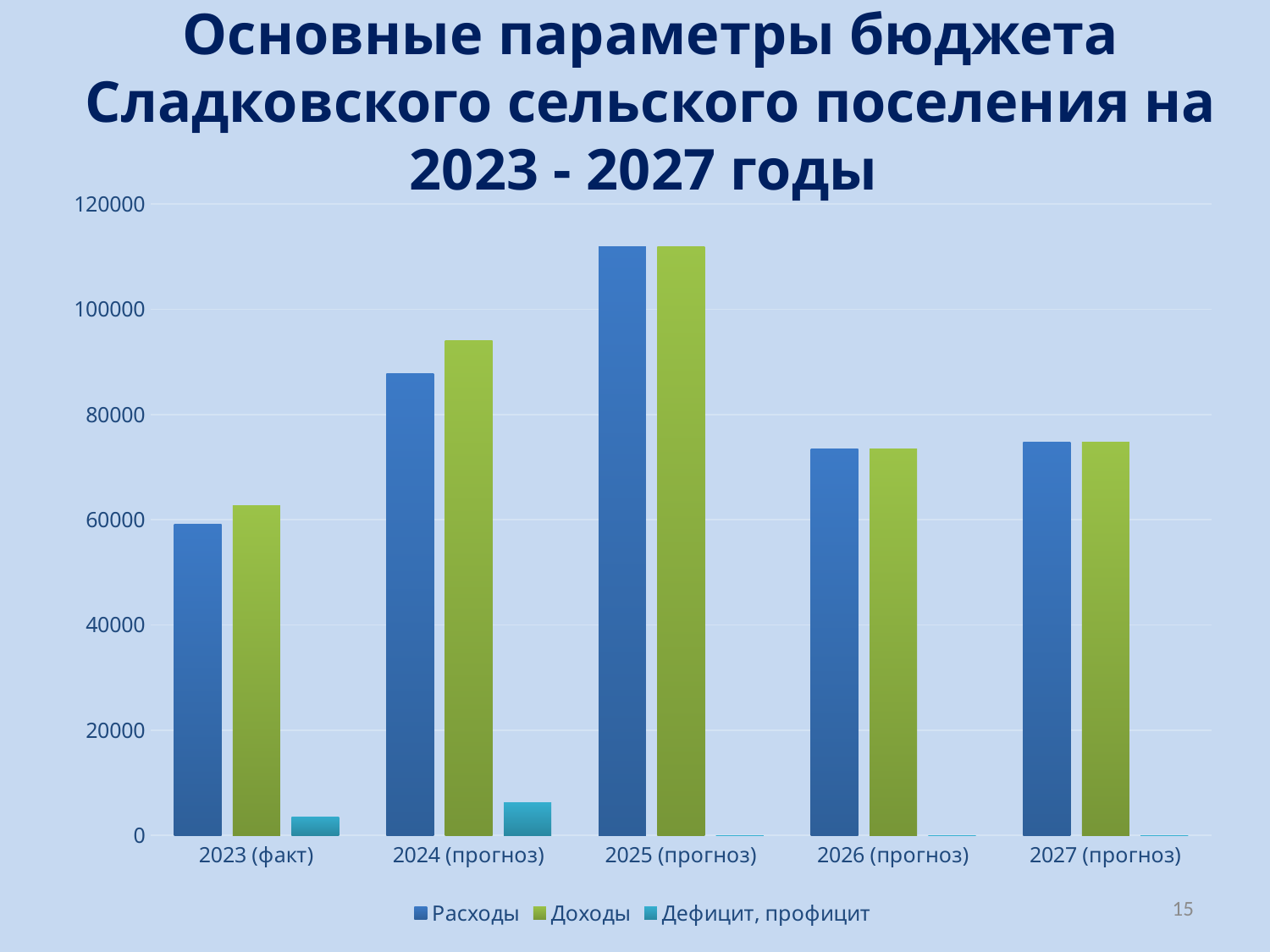
Is the value for Дефицит, профицит in 2024 (прогноз) greater or less than 20000? less In which year is the value for Расходы the lowest? 2023 (факт) How many series does the legend list? 3 In which year is the value for Расходы the highest? 2025 (прогноз) How many year categories are shown on the x axis? 5 Is the value for Расходы in 2024 (прогноз) greater or less than 80000? greater Do the values for Расходы rise or fall from 2023 (факт) to 2025 (прогноз)? rise In which year is the value for Доходы the highest? 2025 (прогноз) Is the value for Доходы in 2025 (прогноз) greater or less than 100000? greater What kind of chart is shown on the slide? bar chart In 2023 (факт), which is larger: Расходы or Доходы? Доходы